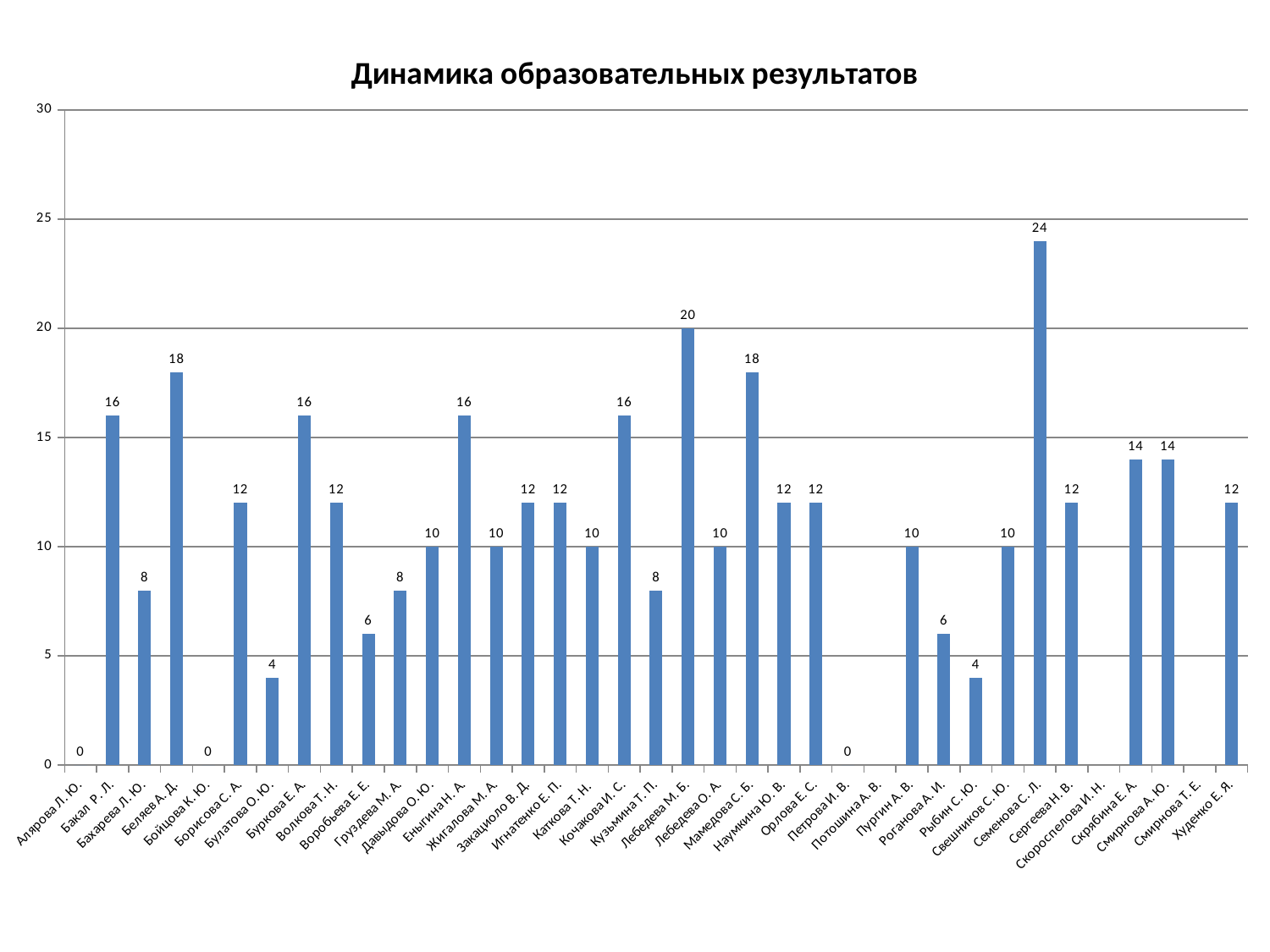
What is the value for Булатова О. Ю.? 4 What is the value for Лебедева М. Б.? 20 What is the title of the chart? Динамика образовательных результатов What kind of chart is shown on the slide? bar chart Which category has the highest value? Семенова С. Л. What is the value for Семенова С. Л.? 24 What is the value for Беляев А. Д.? 18 What is the difference between the values for Семенова С. Л. and Лебедева М. Б.? 4 What is the value for Скрябина Е. А.? 14 What is the difference between the values for Беляев А. Д. and Воробьева Е. Е.? 12 Is the value for Мамедова С. Б. greater or less than 15? greater Which is larger, the value for Беляев А. Д. or the value for Бакал Р. Л.? Беляев А. Д.